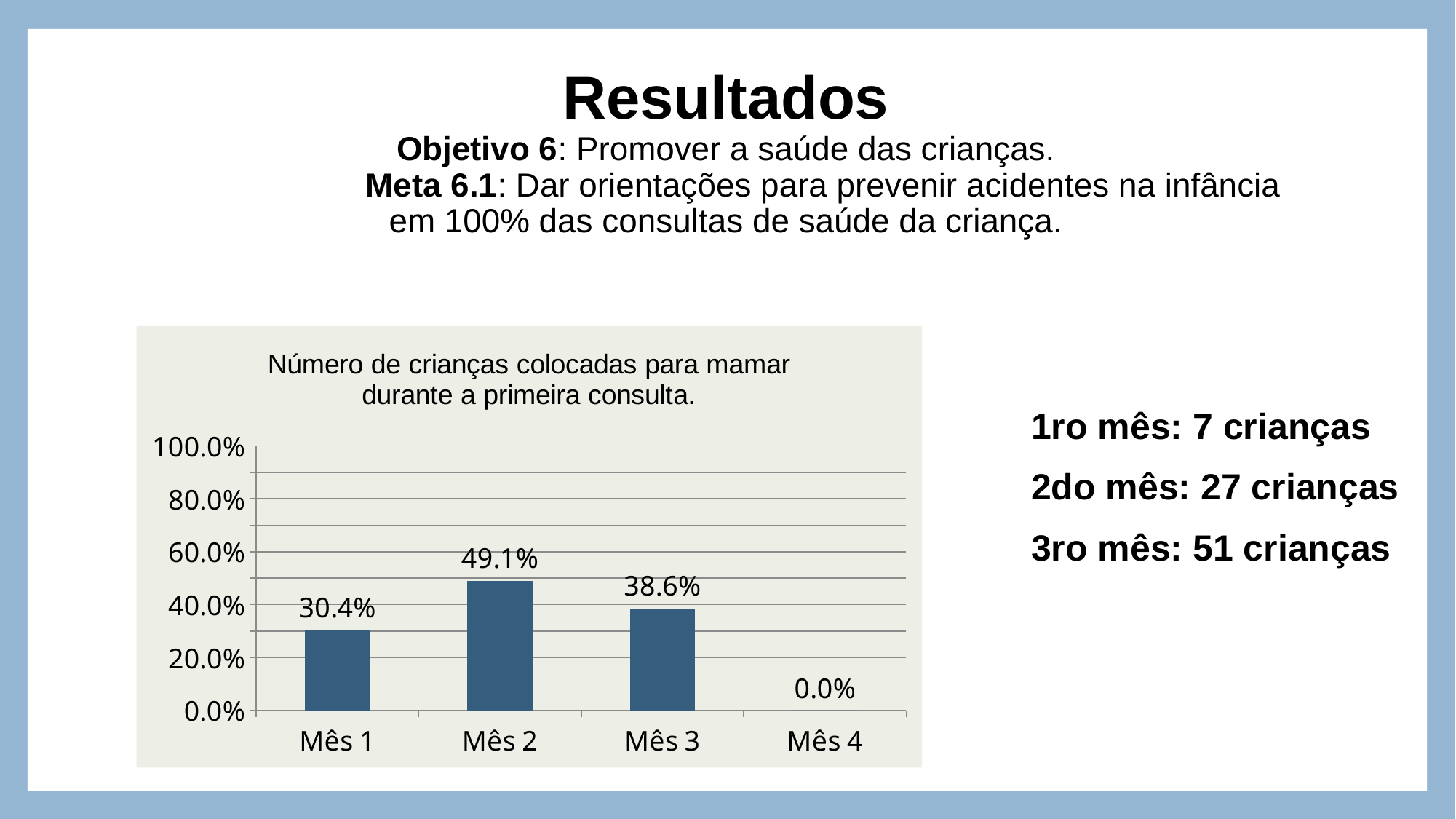
Which month has the lowest value? Mês 4 What is the difference between the values for Mês 2 and Mês 1? 18.7% What is the title of the chart? Número de crianças colocadas para mamar durante a primeira consulta. What is the value for Mês 4? 0.0% How many months are shown on the x axis? 4 Which month has the highest value? Mês 2 What kind of chart is shown on the slide? bar chart Is the value for Mês 2 greater or less than 40.0%? greater What is the value for Mês 1? 30.4% What is the value for Mês 2? 49.1% What is the value for Mês 3? 38.6% Which is larger, the value for Mês 3 or the value for Mês 1? Mês 3